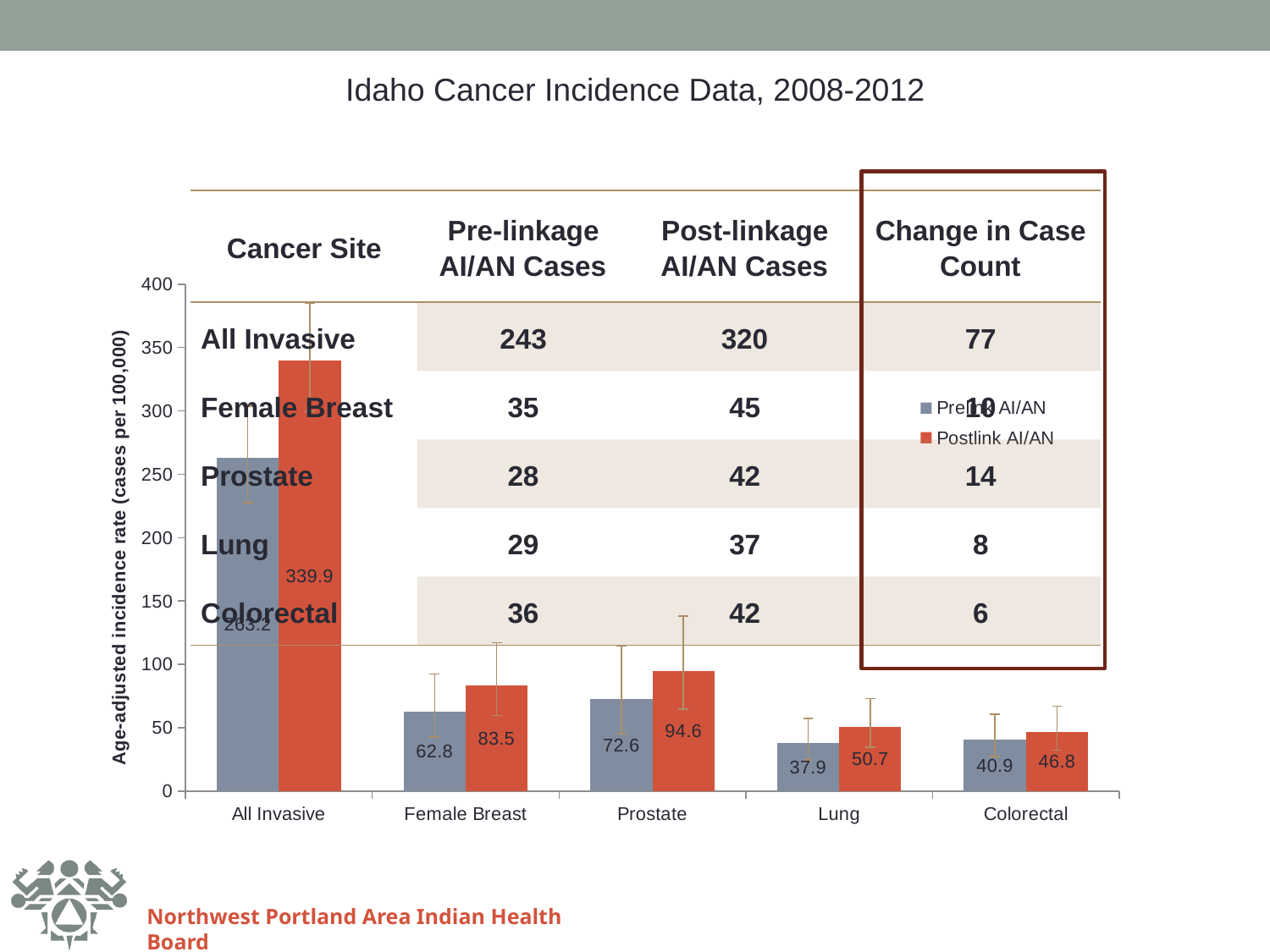
Which cancer site has the highest Postlink AI/AN incidence rate? All Invasive How many series does the chart legend list? 2 What is the Postlink AI/AN incidence rate for Colorectal cancer? 46.8 What kind of chart is shown on the slide? Bar chart Which cancer site has the lowest Prelink AI/AN incidence rate? Lung How many cancer site categories are shown on the x axis of the chart? 5 Which has a larger Postlink AI/AN incidence rate, Prostate or Female Breast? Prostate What is the Prelink AI/AN incidence rate for Female Breast cancer? 62.8 What is the Postlink AI/AN age-adjusted incidence rate for All Invasive cancer? 339.9 What is the Prelink AI/AN incidence rate for Lung cancer? 37.9 How much higher is the Postlink AI/AN rate than the Prelink AI/AN rate for Female Breast cancer? 20.7 What is the Postlink AI/AN incidence rate for Prostate cancer? 94.6